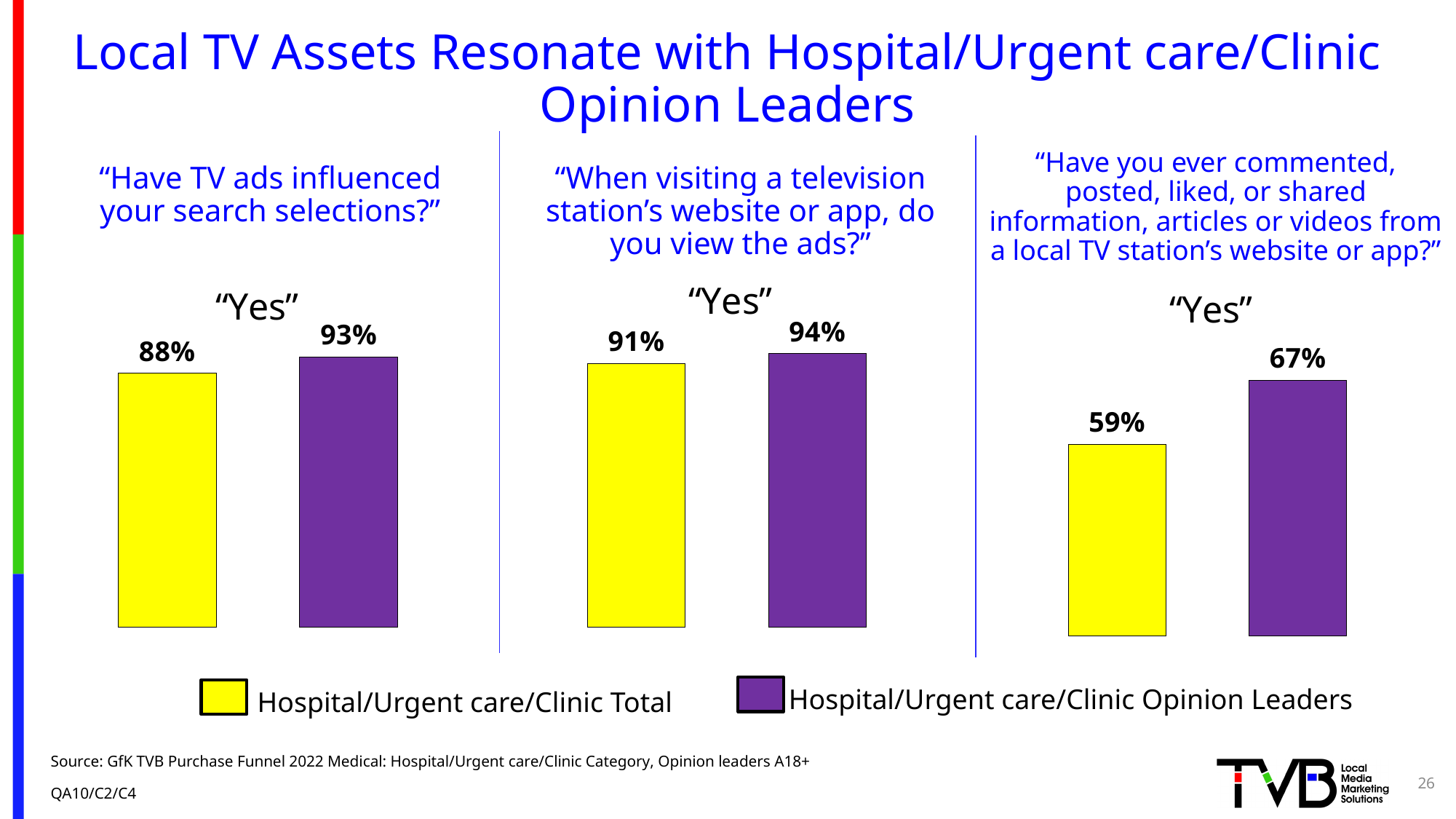
What type of chart is used in the left chart ("Have TV ads influenced your search selections?")? Bar chart In the right chart ("Have you ever commented, posted, liked, or shared..."), which group has the lower value? Hospital/Urgent care/Clinic Total How many series does the legend at the bottom of the slide list? 2 In the left chart ("Have TV ads influenced your search selections?"), what is the difference between the Opinion Leaders value and the Total value? 5 percentage points In the right chart ("Have you ever commented, posted, liked, or shared..."), what is the difference between the Opinion Leaders value and the Total value? 8 percentage points In the right chart ("Have you ever commented, posted, liked, or shared..."), what is the value for Hospital/Urgent care/Clinic Total? 59% In the left chart ("Have TV ads influenced your search selections?"), what percentage of Hospital/Urgent care/Clinic Opinion Leaders answered "Yes"? 93% In the middle chart ("When visiting a television station's website or app, do you view the ads?"), which group has the higher value? Hospital/Urgent care/Clinic Opinion Leaders In the right chart ("Have you ever commented, posted, liked, or shared..."), what is the value for Hospital/Urgent care/Clinic Opinion Leaders? 67% In the middle chart ("When visiting a television station's website or app, do you view the ads?"), what is the value for Hospital/Urgent care/Clinic Total? 91% In the middle chart ("When visiting a television station's website or app, do you view the ads?"), what is the value for Hospital/Urgent care/Clinic Opinion Leaders? 94% In the left chart ("Have TV ads influenced your search selections?"), what percentage of Hospital/Urgent care/Clinic Total answered "Yes"? 88%